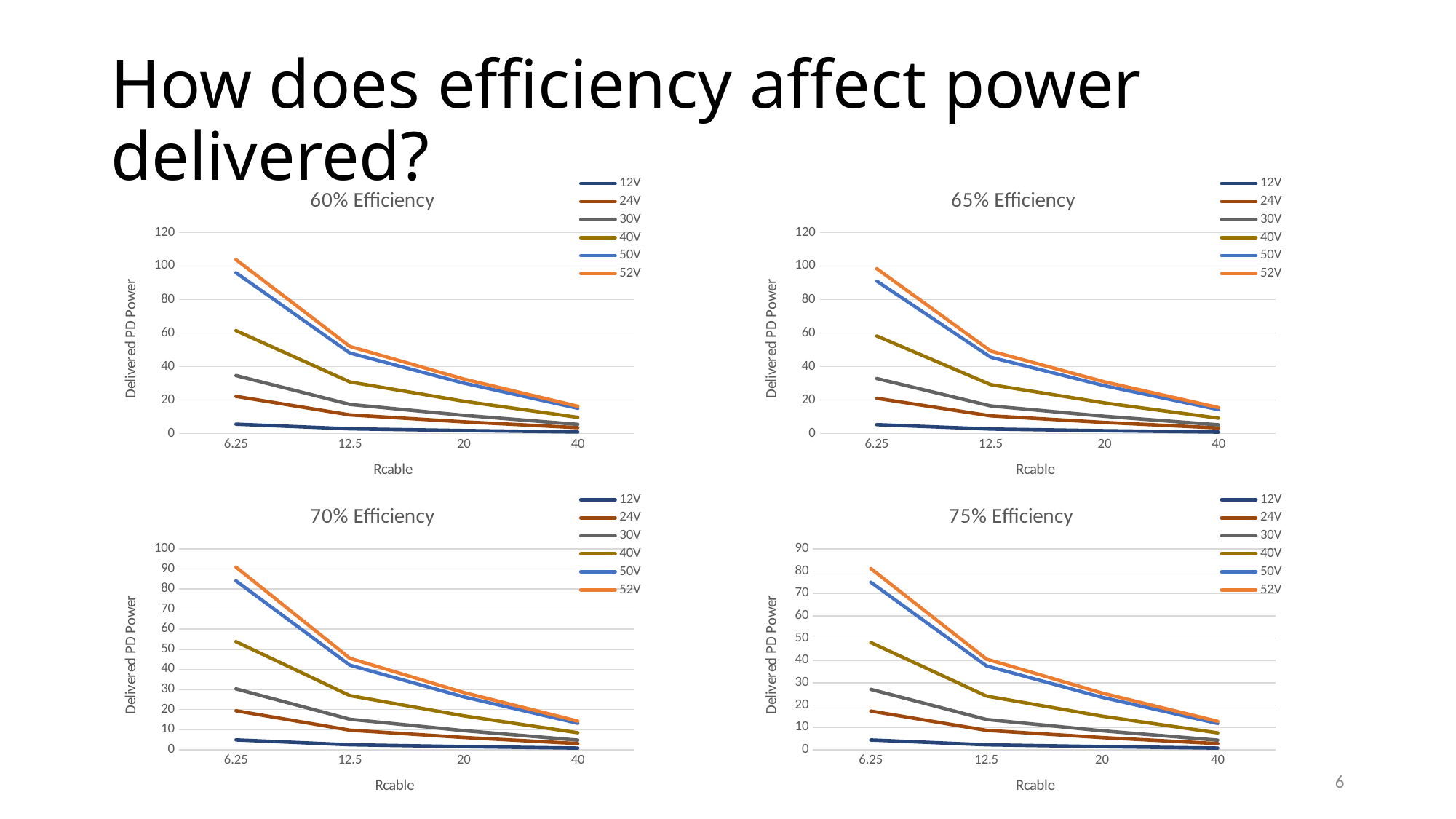
In the "60% Efficiency" chart, at Rcable 12.5, which is larger: 50V or 40V? 50V In the "70% Efficiency" chart, is the value for 40V at Rcable 6.25 greater or less than 50? greater In the "60% Efficiency" chart, does the 52V line rise or fall as Rcable increases? fall What is the x-axis label of the "75% Efficiency" chart? Rcable What is the y-axis label of the "70% Efficiency" chart? Delivered PD Power In the "60% Efficiency" chart, which series has the highest value at Rcable 6.25? 52V In the "65% Efficiency" chart, is the value for 52V at Rcable 40 greater or less than 20? less In the "75% Efficiency" chart, which series has the lowest value at Rcable 6.25? 12V In the "60% Efficiency" chart, is the value for 52V at Rcable 6.25 greater or less than 100? greater What kind of chart is the "60% Efficiency" chart? line chart How many series does the legend of the "60% Efficiency" chart list? 6 How many Rcable values are plotted along the x axis of the "75% Efficiency" chart? 4